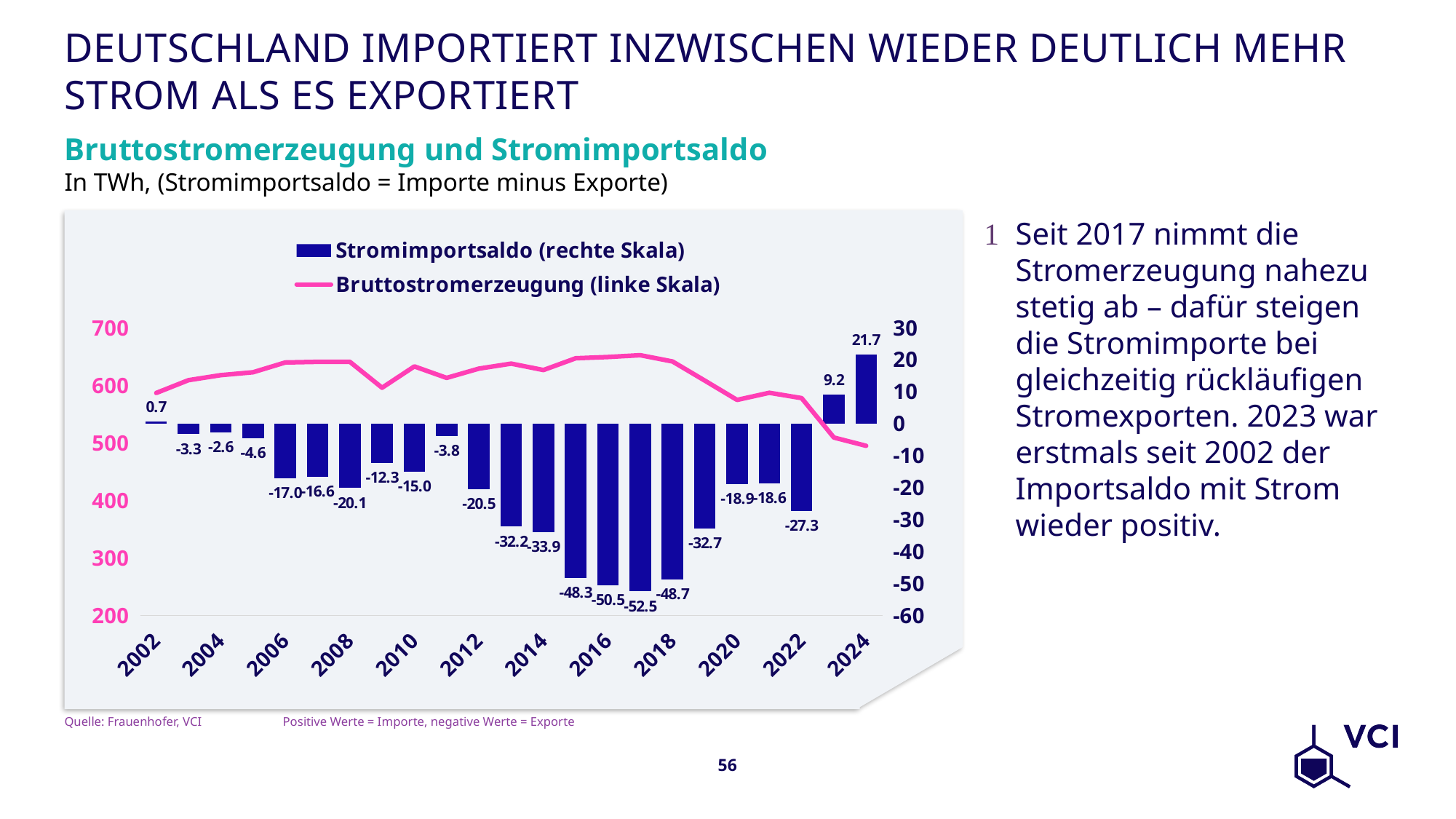
In which year is the Stromimportsaldo bar lowest? 2017 Is the Bruttostromerzeugung value for 2017 greater or less than 600? greater By how much did the Stromimportsaldo increase from 2023 to 2024? 12.5 Which year has the larger Stromimportsaldo, 2013 or 2014? 2013 Does the Bruttostromerzeugung line rise or fall from 2017 to 2024? fall How many series does the legend list? 2 What is the Stromimportsaldo value for 2023? 9.2 What is the Stromimportsaldo value for 2024? 21.7 In which year is the Stromimportsaldo bar highest? 2024 Is the Bruttostromerzeugung value for 2024 greater or less than 600? less What is the Stromimportsaldo value for 2017? -52.5 How many years are plotted as Stromimportsaldo bars? 23